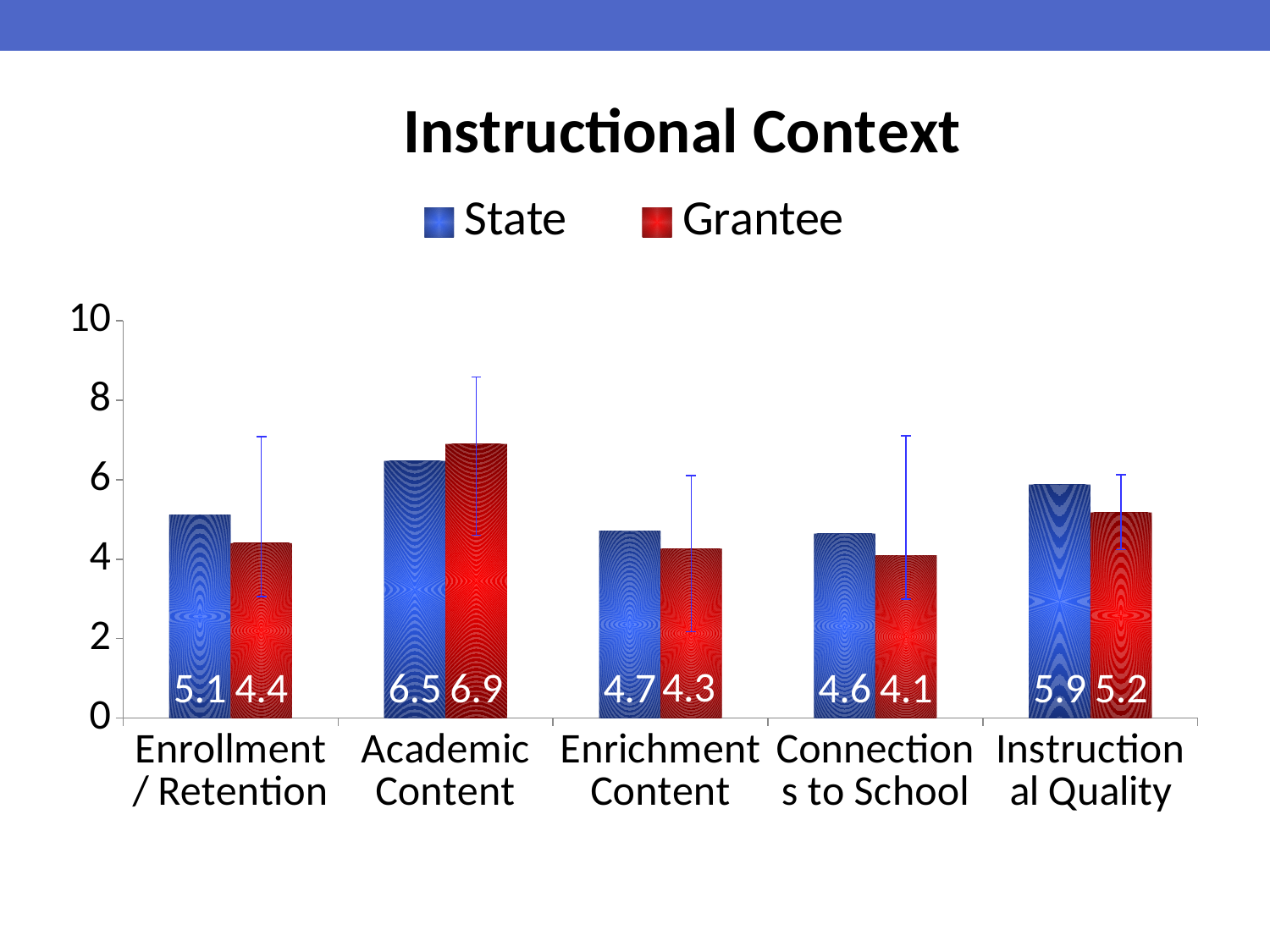
What is the difference between the State and Grantee values for Enrollment / Retention? 0.7 What kind of chart is shown on the slide? bar chart How many categories are shown on the x axis? 5 Is the State value for Instructional Quality greater or less than 4? greater Which category has the lowest State value? Connections to School What is the Grantee value for Instructional Quality? 5.2 Which category has the highest Grantee value? Academic Content What is the State value for Academic Content? 6.5 What is the title of the chart? Instructional Context What is the Grantee value for Connections to School? 4.1 Which is larger for Academic Content, the State value or the Grantee value? Grantee How many series does the legend list? 2